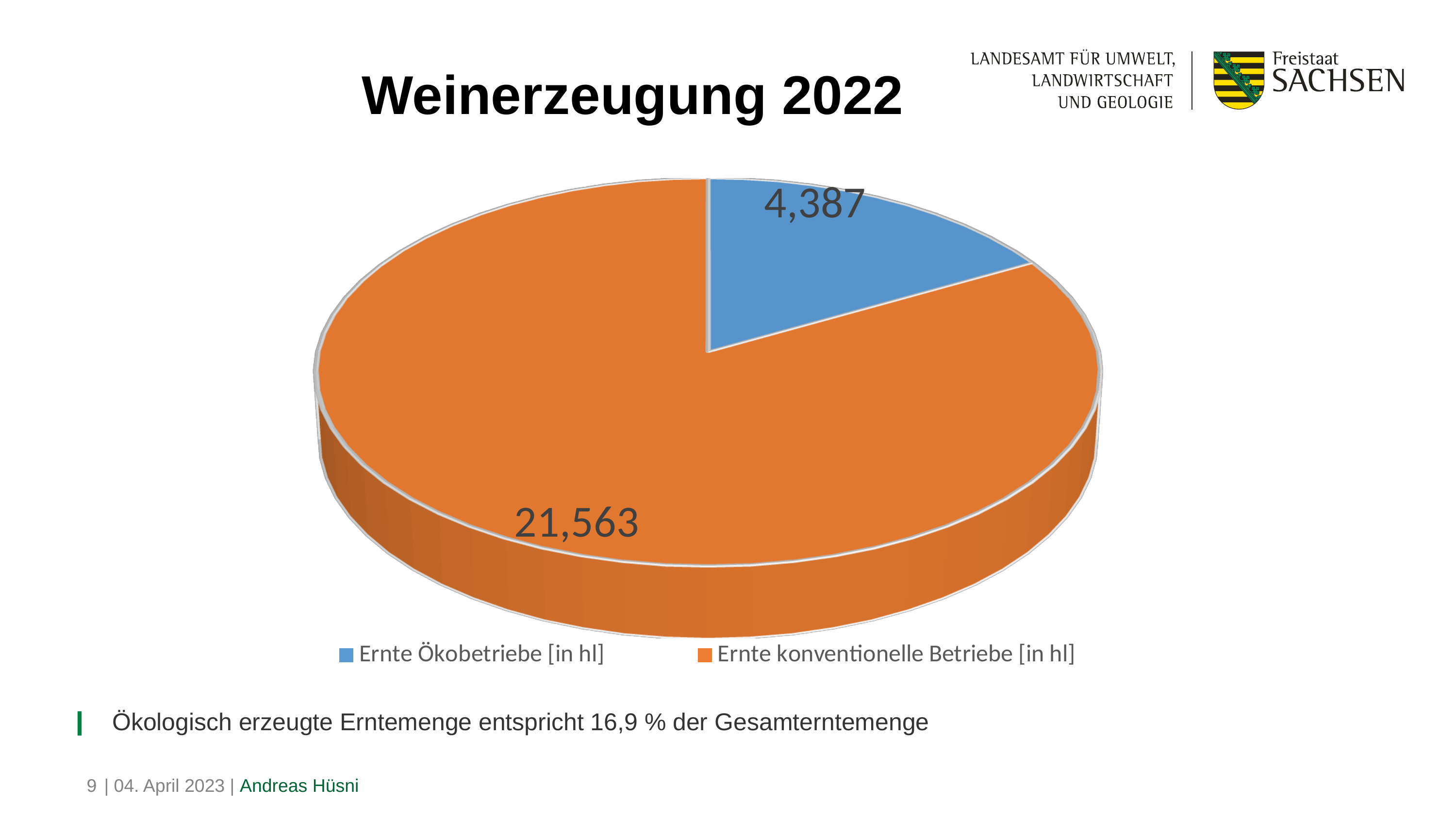
Which is larger: the value for Ernte Ökobetriebe or the value for Ernte konventionelle Betriebe? Ernte konventionelle Betriebe Which slice of the pie chart is the largest? Ernte konventionelle Betriebe [in hl] What kind of chart is shown on the slide? Pie chart What is the total of the two values shown in the pie chart? 25,950 How many slices does the pie chart have? 2 What is the difference between the value for Ernte konventionelle Betriebe and the value for Ernte Ökobetriebe? 17,176 What colour is the slice for Ernte konventionelle Betriebe [in hl]? Orange What is the value for Ernte konventionelle Betriebe [in hl] in the pie chart? 21,563 Which slice of the pie chart is the smallest? Ernte Ökobetriebe [in hl] What share of the total does the Ernte Ökobetriebe slice represent, according to the slide? 16,9 % What is the value for Ernte Ökobetriebe [in hl] in the pie chart? 4,387 How many entries does the legend of the chart list? 2